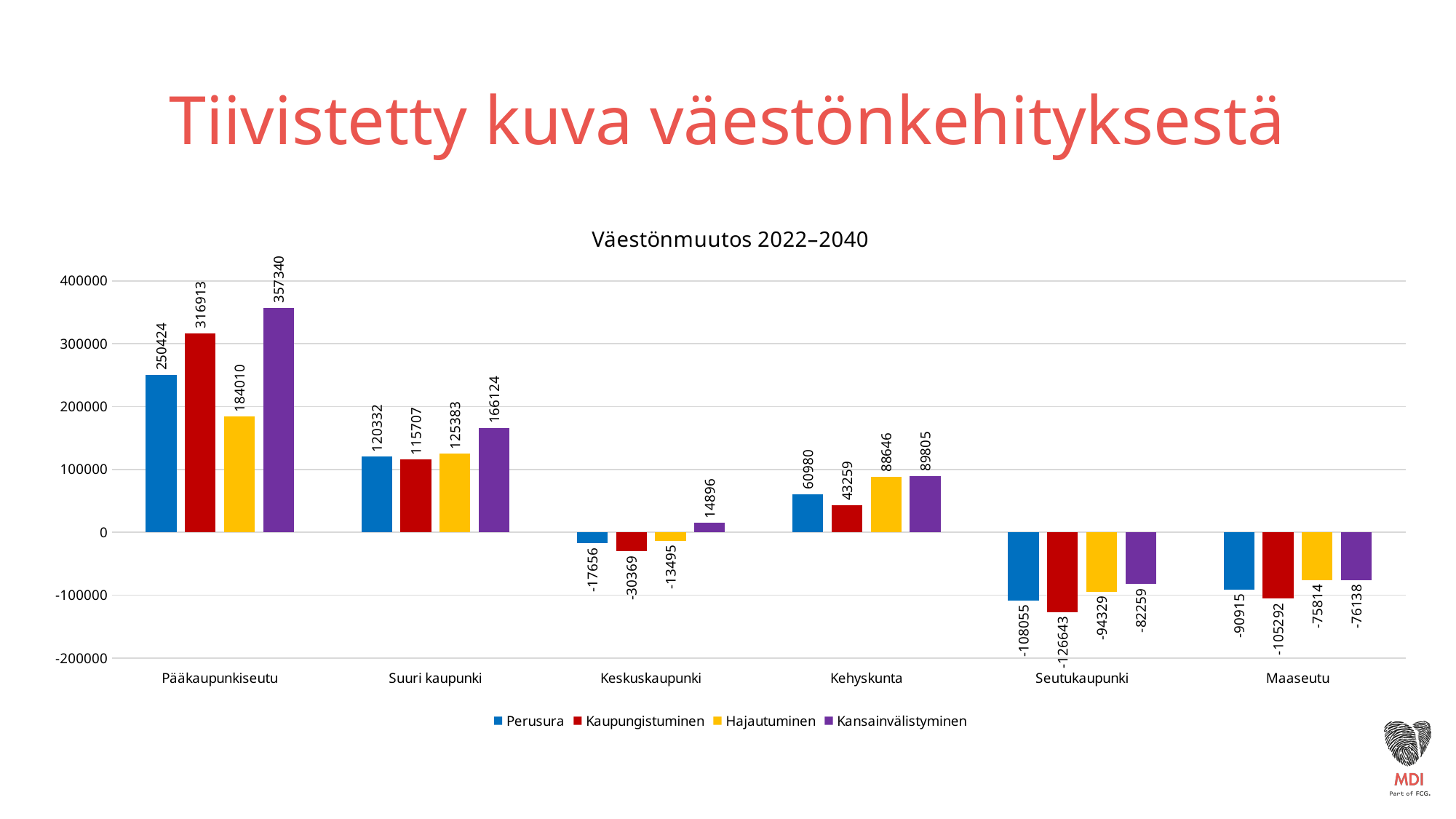
How many categories are shown on the x axis? 6 In Suuri kaupunki, which is larger: Hajautuminen or Perusura? Hajautuminen What is the title of the chart? Väestönmuutos 2022–2040 What is the difference between Kaupungistuminen and Perusura in Pääkaupunkiseutu? 66489 Which bar has the lowest value in the chart? Kaupungistuminen in Seutukaupunki (-126643) What is the difference between Perusura and Kaupungistuminen in Maaseutu? 14377 Which bar has the highest value in the chart? Kansainvälistyminen in Pääkaupunkiseutu (357340) Is the value for Perusura in Seutukaupunki greater or less than -100000? less What is the value for Perusura in Kehyskunta? 60980 What is the value for Kansainvälistyminen in Pääkaupunkiseutu? 357340 What is the value for Kaupungistuminen in Seutukaupunki? -126643 How many series does the legend list? 4